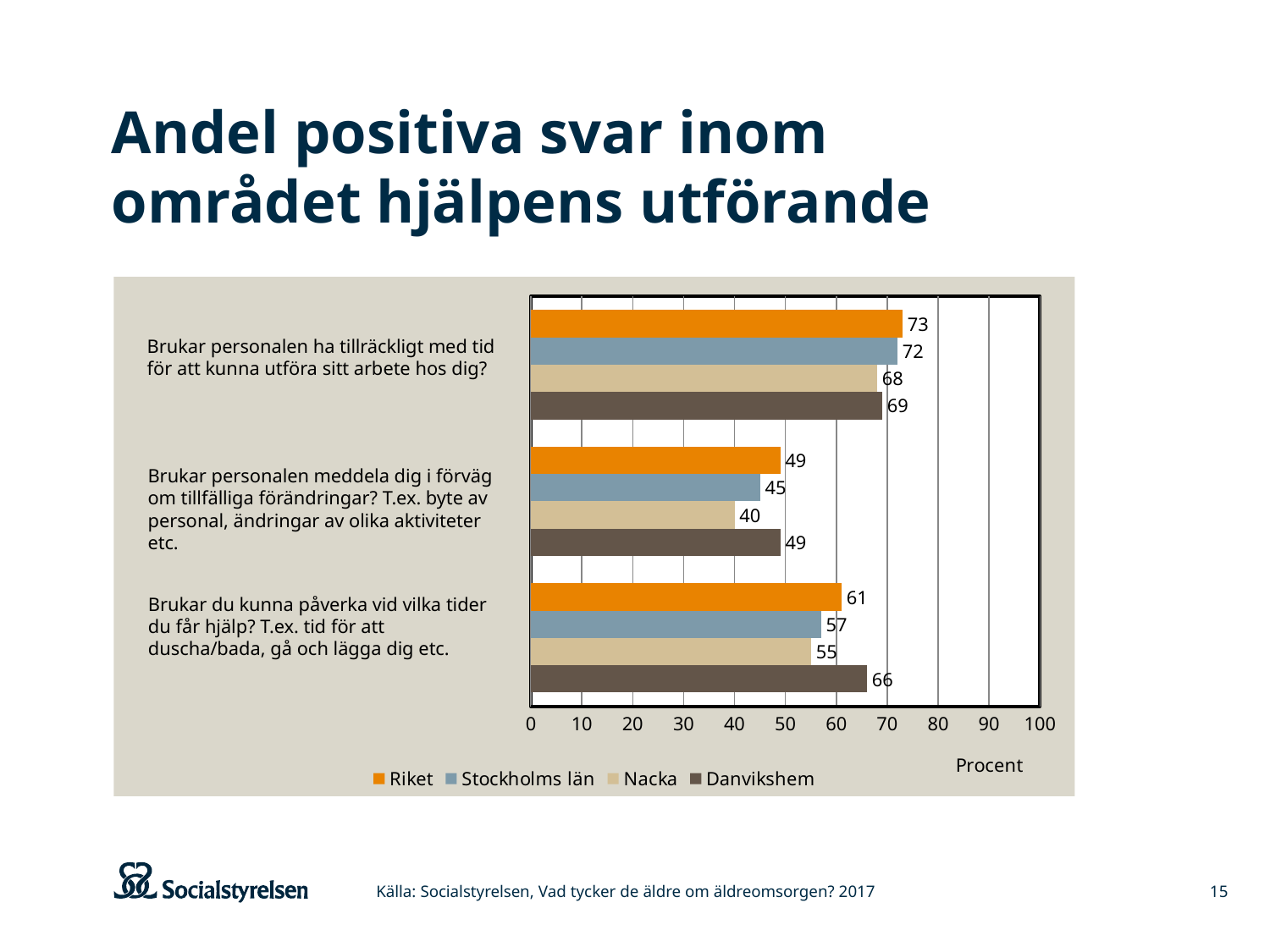
What is the value for Riket on the question "Brukar personalen ha tillräckligt med tid för att kunna utföra sitt arbete hos dig?"? 73 How many series does the legend list? 4 What is the value for Nacka on the question "Brukar personalen meddela dig i förväg om tillfälliga förändringar?"? 40 Which series has the highest value on the question "Brukar du kunna påverka vid vilka tider du får hjälp?"? Danvikshem Which series has the lowest value on the question "Brukar personalen meddela dig i förväg om tillfälliga förändringar?"? Nacka What is the difference between Danvikshem and Nacka on the question "Brukar du kunna påverka vid vilka tider du får hjälp?"? 11 Which is larger on the question "Brukar personalen meddela dig i förväg om tillfälliga förändringar?": Stockholms län or Nacka? Stockholms län What is the value for Danvikshem on the question "Brukar du kunna påverka vid vilka tider du får hjälp?"? 66 How many question categories are shown on the chart? 3 What is the difference between Riket and Nacka on the question "Brukar personalen ha tillräckligt med tid för att kunna utföra sitt arbete hos dig?"? 5 What type of chart is shown on the slide? Bar chart What is the value for Stockholms län on the question "Brukar du kunna påverka vid vilka tider du får hjälp?"? 57